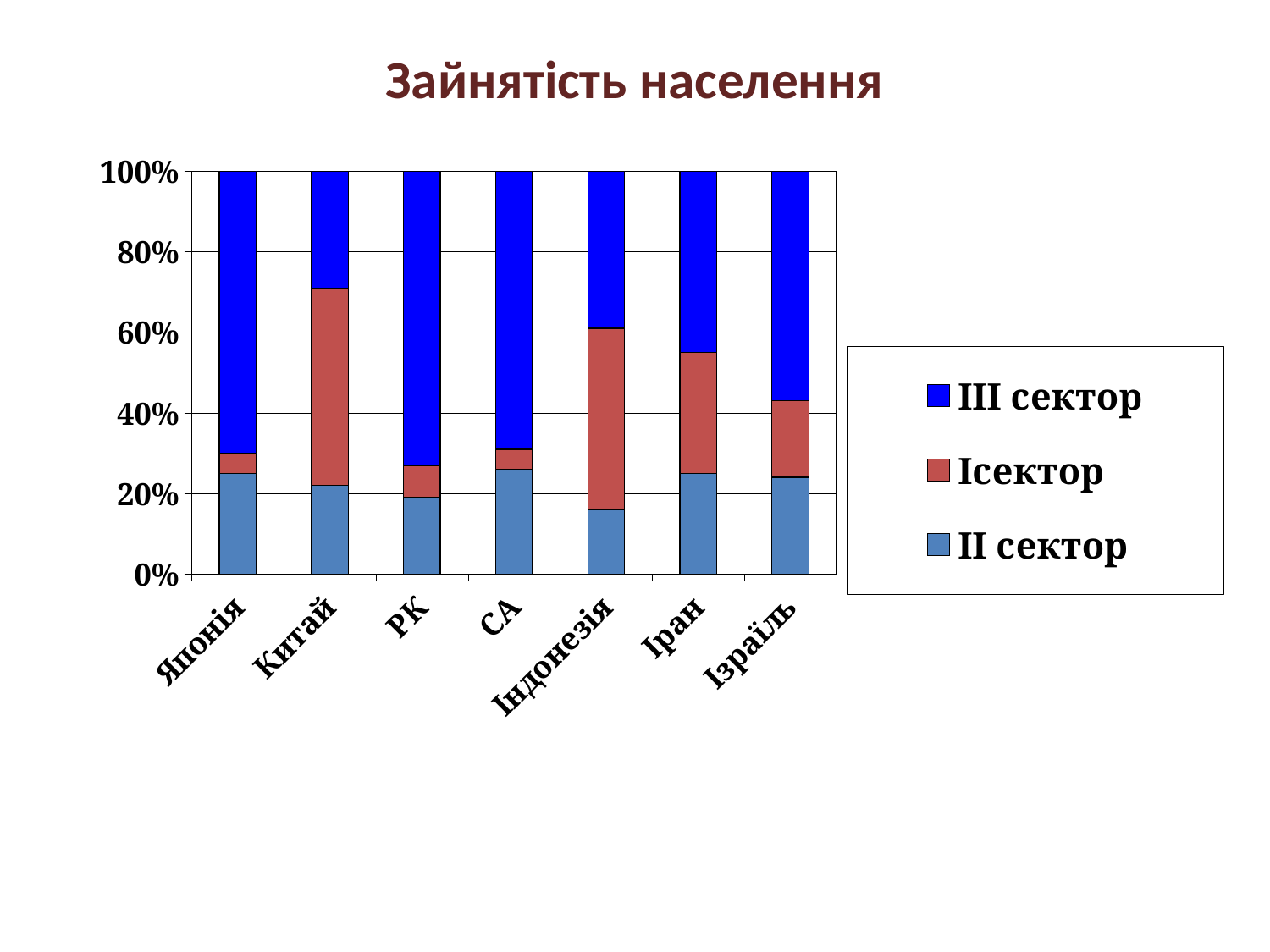
How many series does the legend list? 3 What is the title of the chart? Зайнятість населення Is the value of III сектор for Китай greater or less than 40%? less Which country has the smallest III сектор segment? Китай Is the value of II сектор for Японія greater or less than 20%? greater Which series is shown in blue in the chart? III сектор Which country has the largest I сектор segment? Китай How many countries are shown on the x axis of the chart? 7 What is the total of the stacked bar for Іран? 100% Is the value of II сектор for Індонезія greater or less than 20%? less What kind of chart is shown on the slide? stacked bar chart